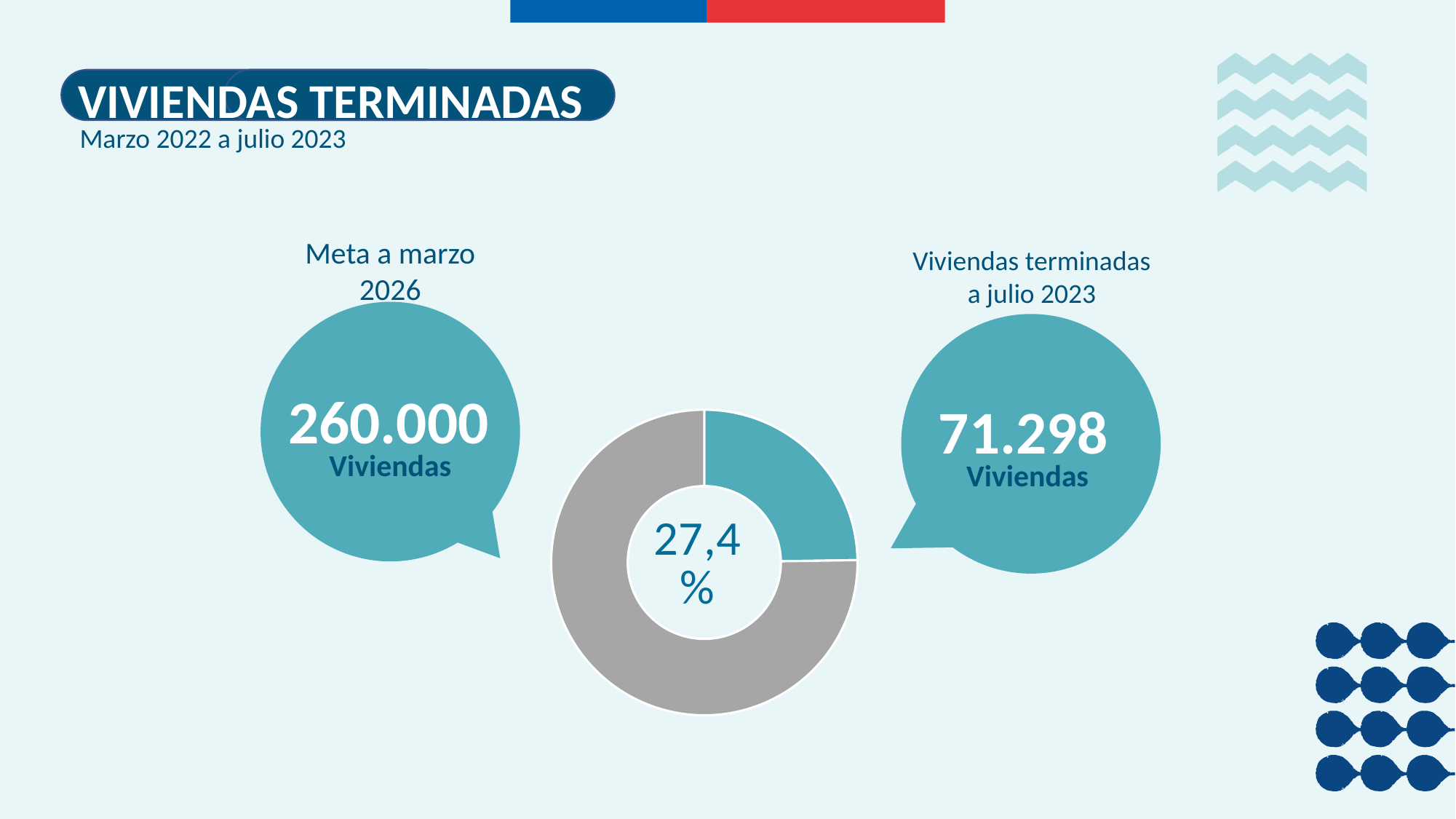
Which slice of the donut chart is larger, the teal one or the grey one? the grey one What percentage is printed in the centre of the donut chart? 27,4% How many slices does the donut chart have? 2 What is the difference between the 'Meta a marzo 2026' value and the 'Viviendas terminadas a julio 2023' value? 188.702 What kind of chart is shown in the centre of the slide? donut (pie) chart What is the value shown for 'Meta a marzo 2026'? 260.000 Viviendas What is the value shown for 'Viviendas terminadas a julio 2023'? 71.298 Viviendas Is the share represented by the teal slice of the donut chart greater or less than 50%? less Which is larger, the 'Meta a marzo 2026' value or the 'Viviendas terminadas a julio 2023' value? Meta a marzo 2026 What is the title of the slide? VIVIENDAS TERMINADAS What period is stated under the slide title? Marzo 2022 a julio 2023